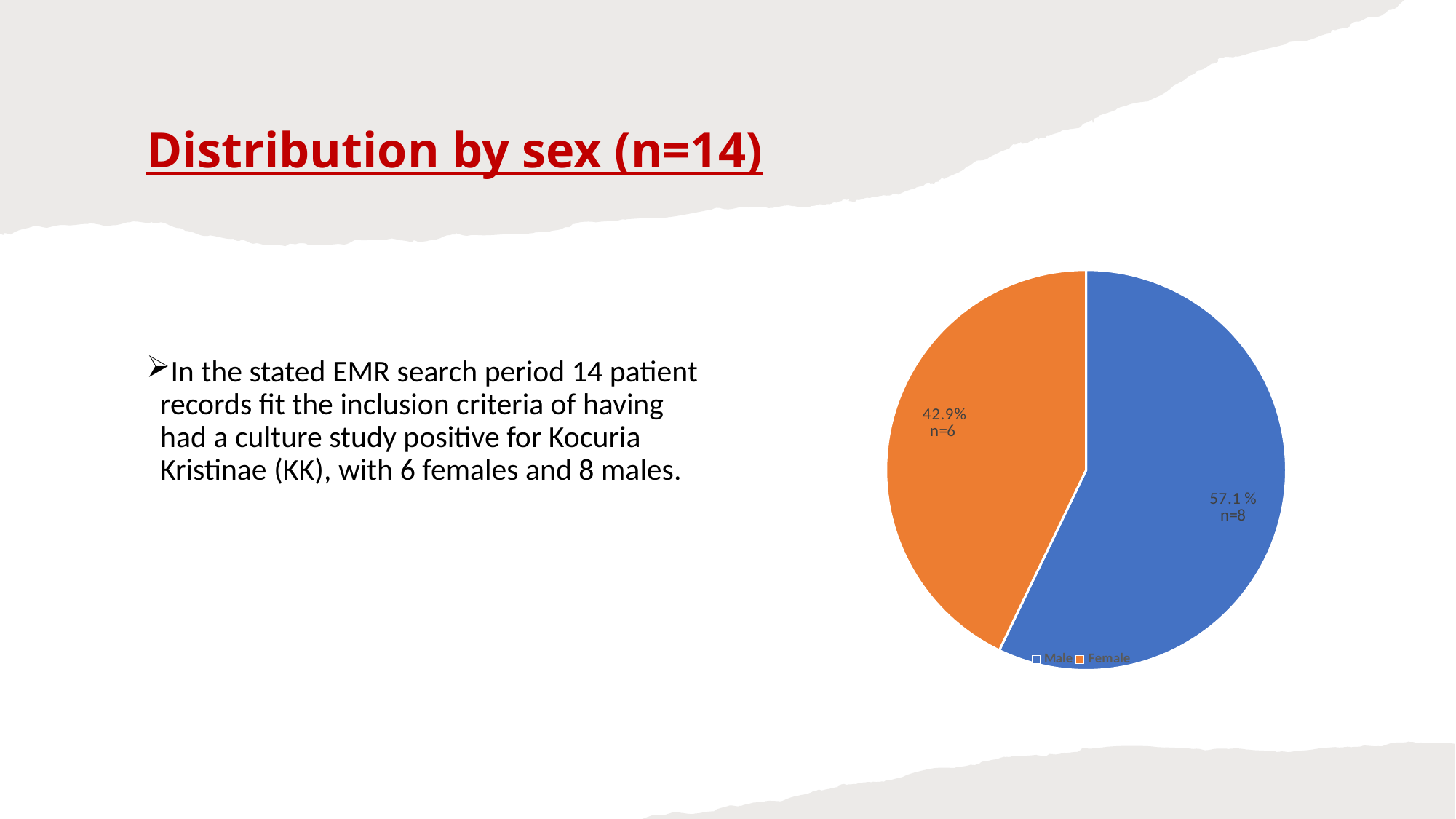
What colour is the Female slice? orange Which slice is the largest? Male What percentage of the pie does the Female slice represent? 42.9% How many patients are in the Female slice? n=6 What kind of chart is shown on the slide? pie chart Which slice is larger, Male or Female? Male What is the difference in patient count between the Male and Female slices? 2 How many patients are in the Male slice? n=8 How many entries does the legend list? 2 What percentage of the pie does the Male slice represent? 57.1 % How many slices does the pie chart have? 2 Which slice is the smallest? Female